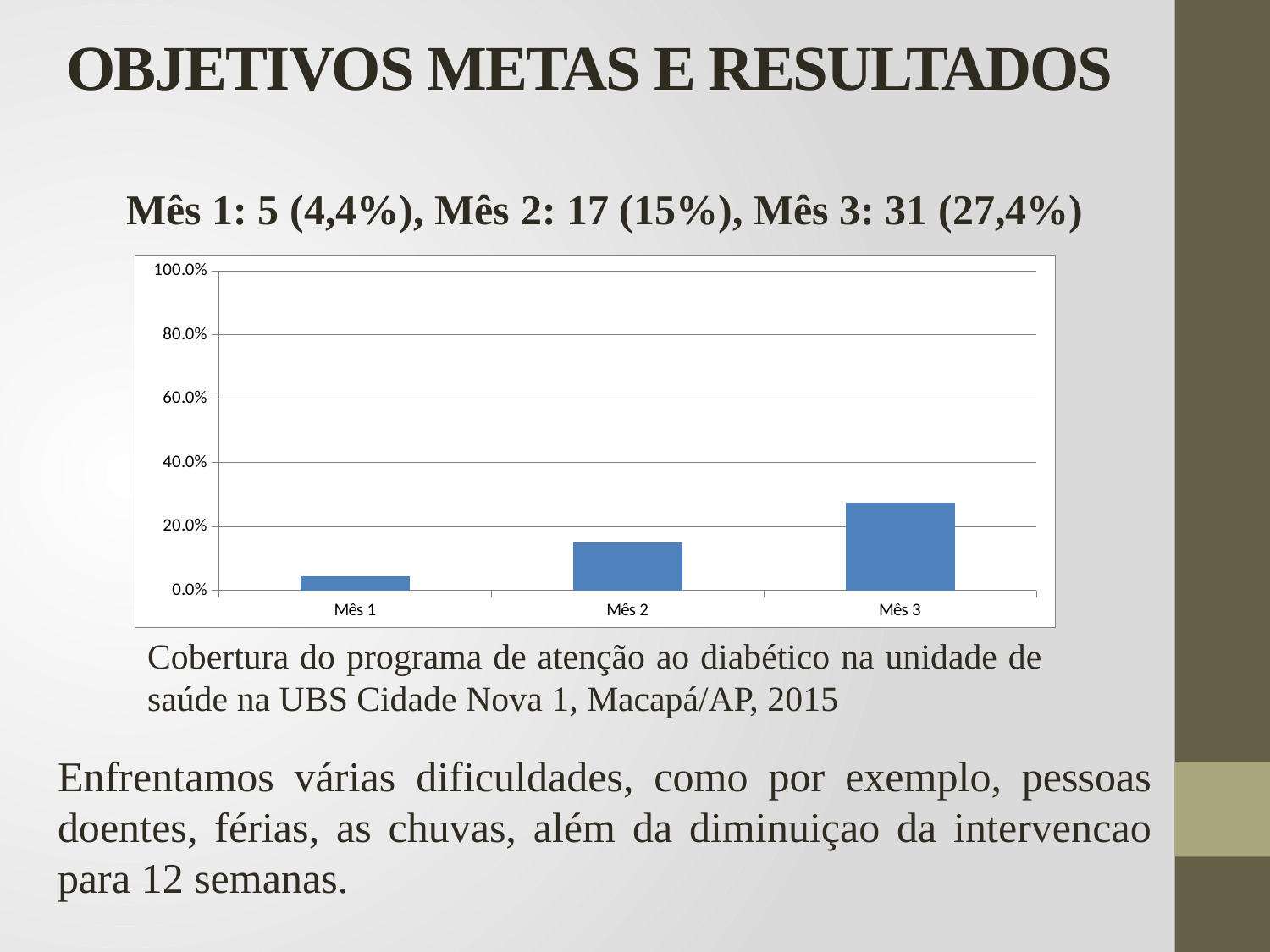
Which month has the highest bar on the chart? Mês 3 Is the value for Mês 3 greater or less than 20.0%? greater Do the values rise or fall from Mês 1 to Mês 3? rise What is the highest value shown on the chart's vertical axis? 100.0% Which is larger, the value for Mês 2 or the value for Mês 1? Mês 2 According to the text above the chart, what percentage is shown for Mês 3? 27,4% What kind of chart is shown on the slide? bar chart Which month has the lowest bar on the chart? Mês 1 Is the value for Mês 1 greater or less than 20.0%? less Is the value for Mês 2 greater or less than 20.0%? less How many categories (months) are plotted on the chart? 3 According to the text above the chart, what percentage is shown for Mês 1? 4,4%